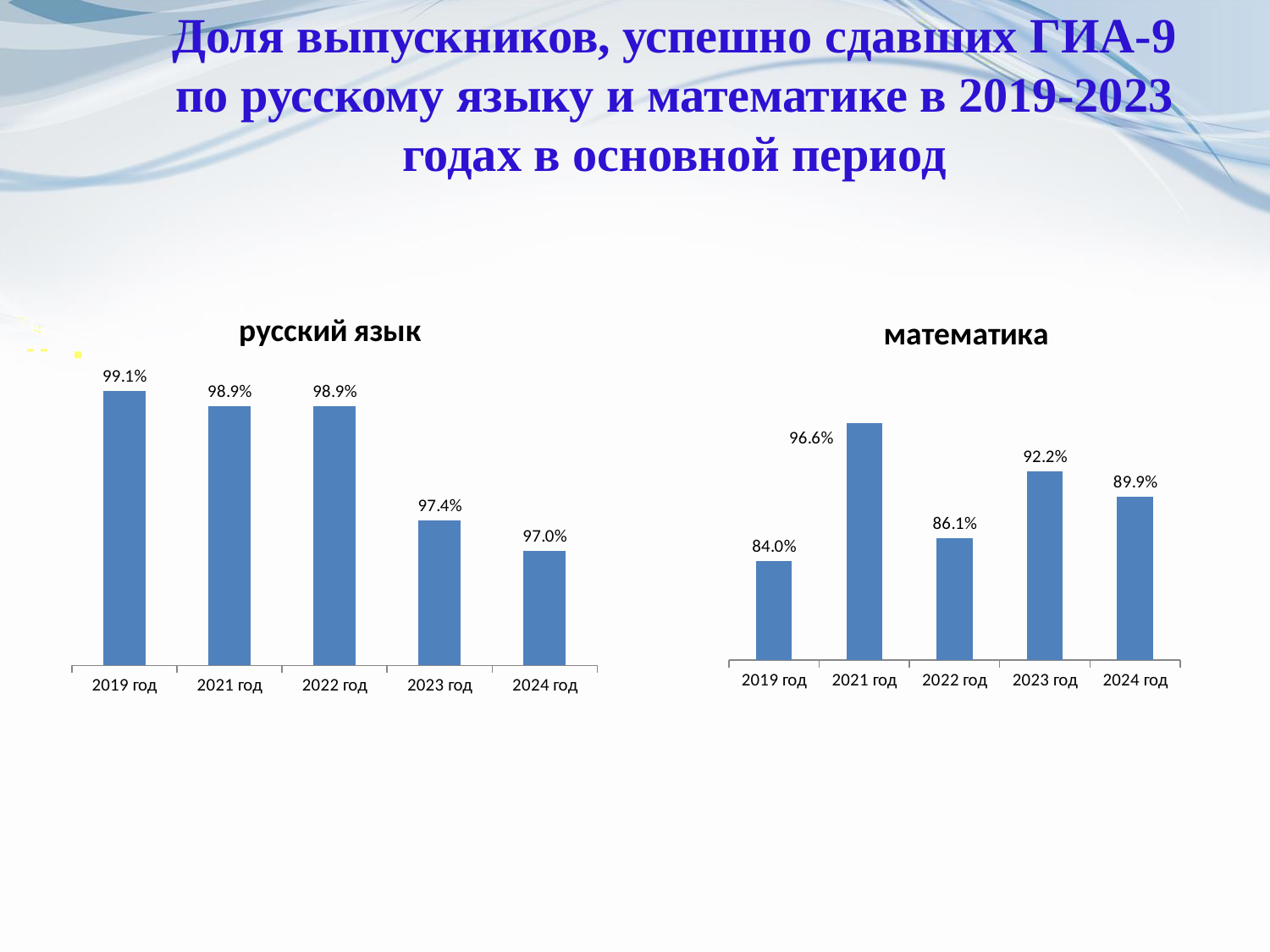
In the 'русский язык' chart, which year has the lowest value? 2024 год In the 'математика' chart, which year has the highest value? 2021 год In the 'математика' chart, what is the difference between the values for 2021 год and 2019 год? 12.6% In the 'русский язык' chart, what is the difference between the values for 2019 год and 2024 год? 2.1% In the 'математика' chart, which year has the lowest value? 2019 год What type of chart is the 'математика' chart? bar chart How many bars are in the 'русский язык' chart? 5 In the 'математика' chart, what is the value for 2023 год? 92.2% In the 'математика' chart, which is larger: the value for 2023 год or the value for 2024 год? 2023 год In the 'математика' chart, what is the value for 2022 год? 86.1% In the 'русский язык' chart, what is the value for 2019 год? 99.1% In the 'русский язык' chart, what is the value for 2024 год? 97.0%